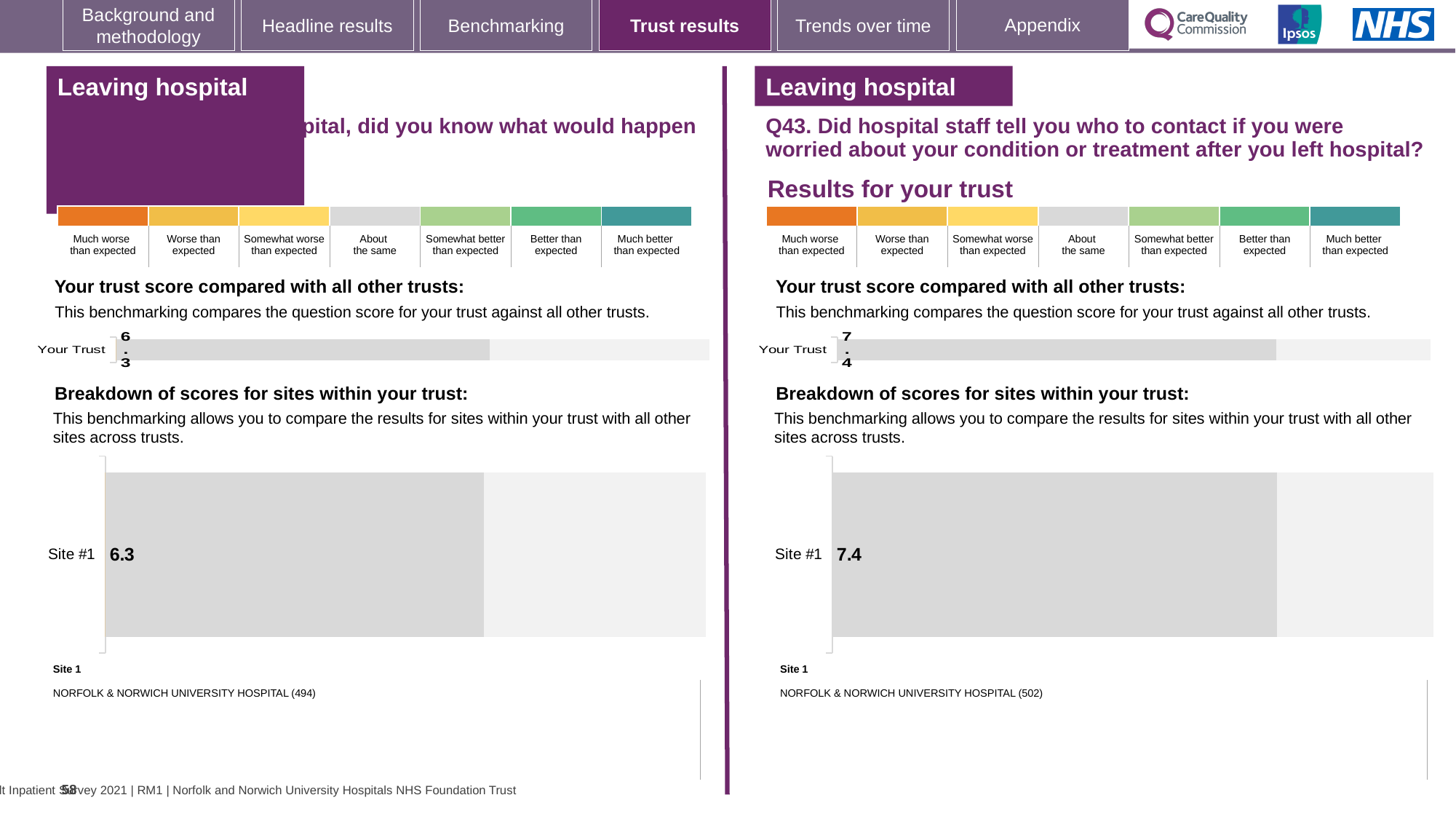
Is the Your Trust score on the left panel greater or less than 7? less What type of chart is used to show the Site #1 score on the left panel? Bar chart Which is larger: the Site #1 score on the left panel or the Site #1 score on the right panel (Q43)? Right panel (Q43), 7.4 Is the Your Trust score on the right panel (Q43) greater or less than 7? greater What is the difference between the Site #1 score on the right panel (Q43) and the Site #1 score on the left panel? 1.1 How many sites are shown in the 'Breakdown of scores for sites within your trust' chart on the right panel (Q43)? 1 On the right panel (Q43), which site is listed as Site 1 below the breakdown chart? NORFOLK & NORWICH UNIVERSITY HOSPITAL (502) On the left panel, what is the score shown for Your Trust in the 'Your trust score compared with all other trusts' chart? 6.3 On the left panel, which site is listed as Site 1 below the breakdown chart? NORFOLK & NORWICH UNIVERSITY HOSPITAL (494) On the left panel, what is the score for Site #1 in the 'Breakdown of scores for sites within your trust' chart? 6.3 On the right panel (Q43), what is the score for Site #1 in the 'Breakdown of scores for sites within your trust' chart? 7.4 On the right panel (Q43), what is the score shown for Your Trust in the 'Your trust score compared with all other trusts' chart? 7.4